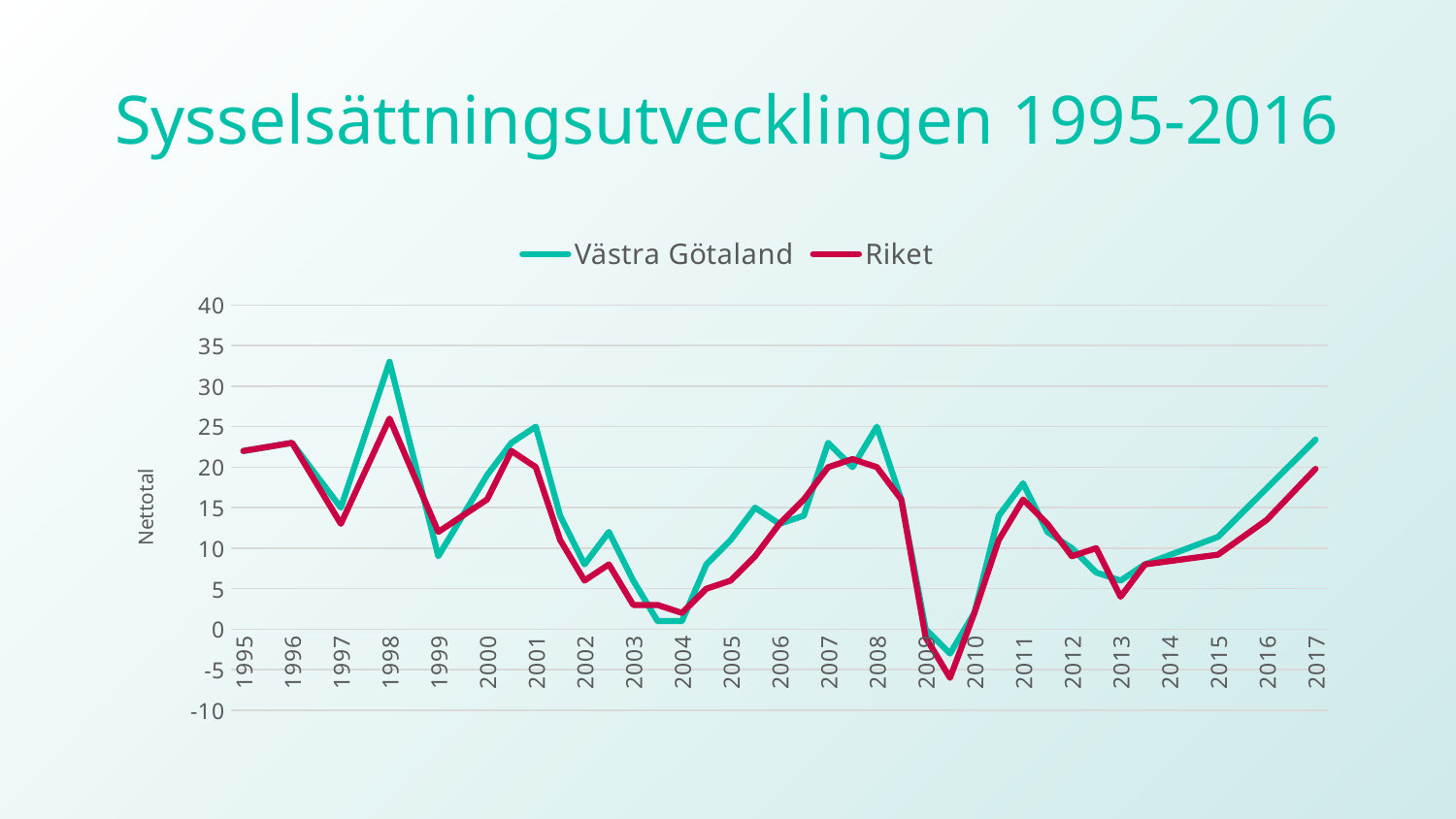
In which year does the Västra Götaland line reach its highest value? 1998 Do the values for both series rise or fall from 2013 to 2017? rise Is the value for Riket in 2009 greater or less than 0? less Is the value for Västra Götaland in 1998 greater or less than 30? greater Which series has the higher value in 2017, Västra Götaland or Riket? Västra Götaland Is the value for Riket in 2002 greater or less than 10? less How many series does the legend list? 2 What is the label on the vertical axis? Nettotal In which year does the Riket line reach its lowest value? 2009 Which series has the higher value in 1998, Västra Götaland or Riket? Västra Götaland What kind of chart is shown on the slide? line chart